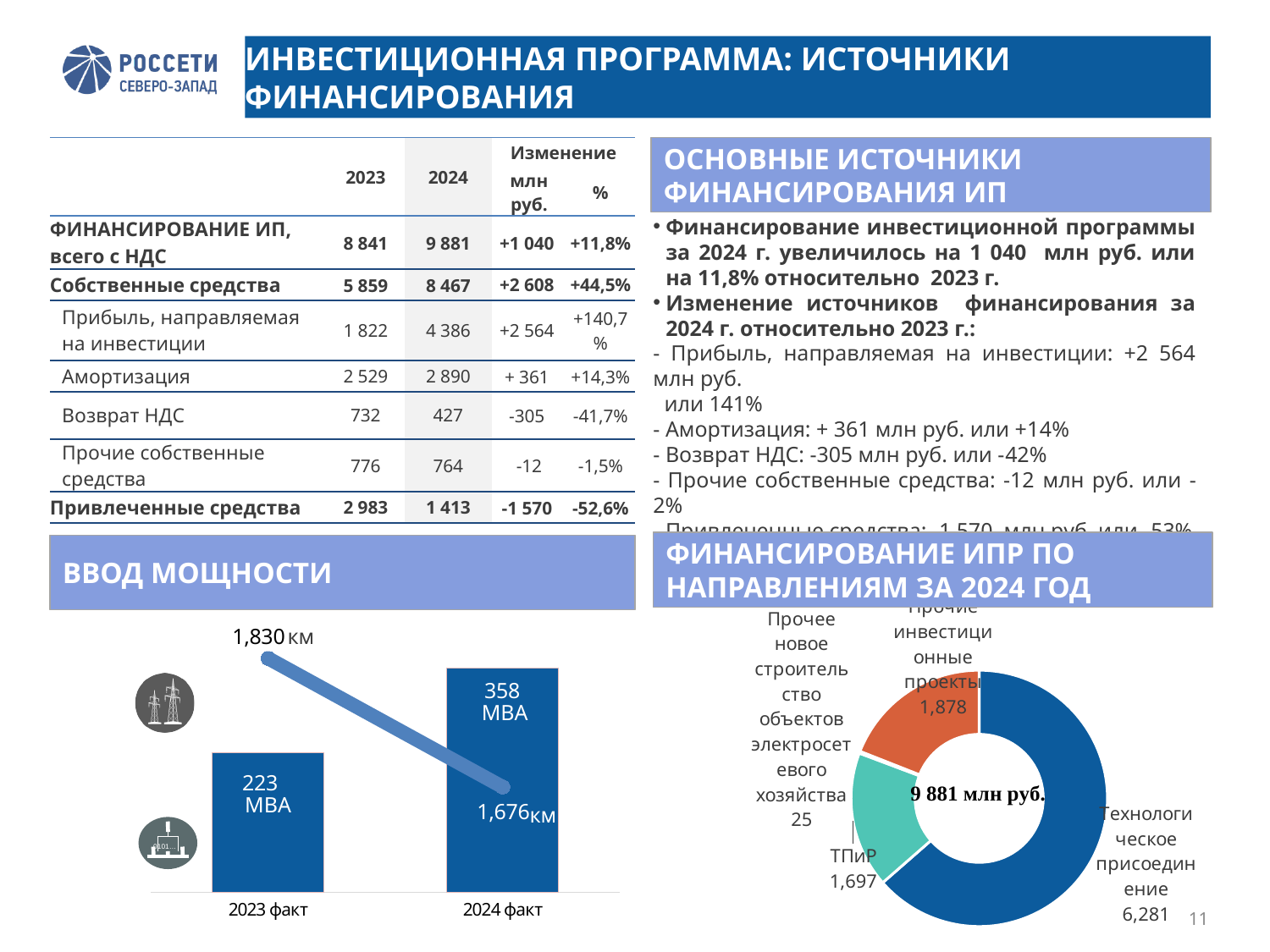
In the 'ВВОД МОЩНОСТИ' chart, by how many МВА does the 2024 факт bar exceed the 2023 факт bar? 135 МВА In the 'ВВОД МОЩНОСТИ' chart, how many categories are shown on the x axis? 2 In the 'ФИНАНСИРОВАНИЕ ИПР ПО НАПРАВЛЕНИЯМ ЗА 2024 ГОД' chart, which is larger: Прочие инвестиционные проекты or ТПиР? Прочие инвестиционные проекты In the 'ФИНАНСИРОВАНИЕ ИПР ПО НАПРАВЛЕНИЯМ ЗА 2024 ГОД' chart, what is the value for ТПиР? 1,697 In the 'ФИНАНСИРОВАНИЕ ИПР ПО НАПРАВЛЕНИЯМ ЗА 2024 ГОД' chart, what is the value for Технологическое присоединение? 6,281 In the 'ВВОД МОЩНОСТИ' chart, does the km line rise or fall from 2023 факт to 2024 факт? fall What total value is printed in the centre of the 'ФИНАНСИРОВАНИЕ ИПР ПО НАПРАВЛЕНИЯМ ЗА 2024 ГОД' doughnut chart? 9 881 млн руб. In the 'ВВОД МОЩНОСТИ' chart, what is the line value (km) for 2023 факт? 1,830 км In the 'ВВОД МОЩНОСТИ' chart, what is the value of the bar for 2023 факт? 223 МВА In the 'ВВОД МОЩНОСТИ' chart, what is the value of the bar for 2024 факт? 358 МВА In the 'ВВОД МОЩНОСТИ' chart, what is the line value (km) for 2024 факт? 1,676 км In the 'ФИНАНСИРОВАНИЕ ИПР ПО НАПРАВЛЕНИЯМ ЗА 2024 ГОД' chart, which category has the smallest value? Прочее новое строительство объектов электросетевого хозяйства